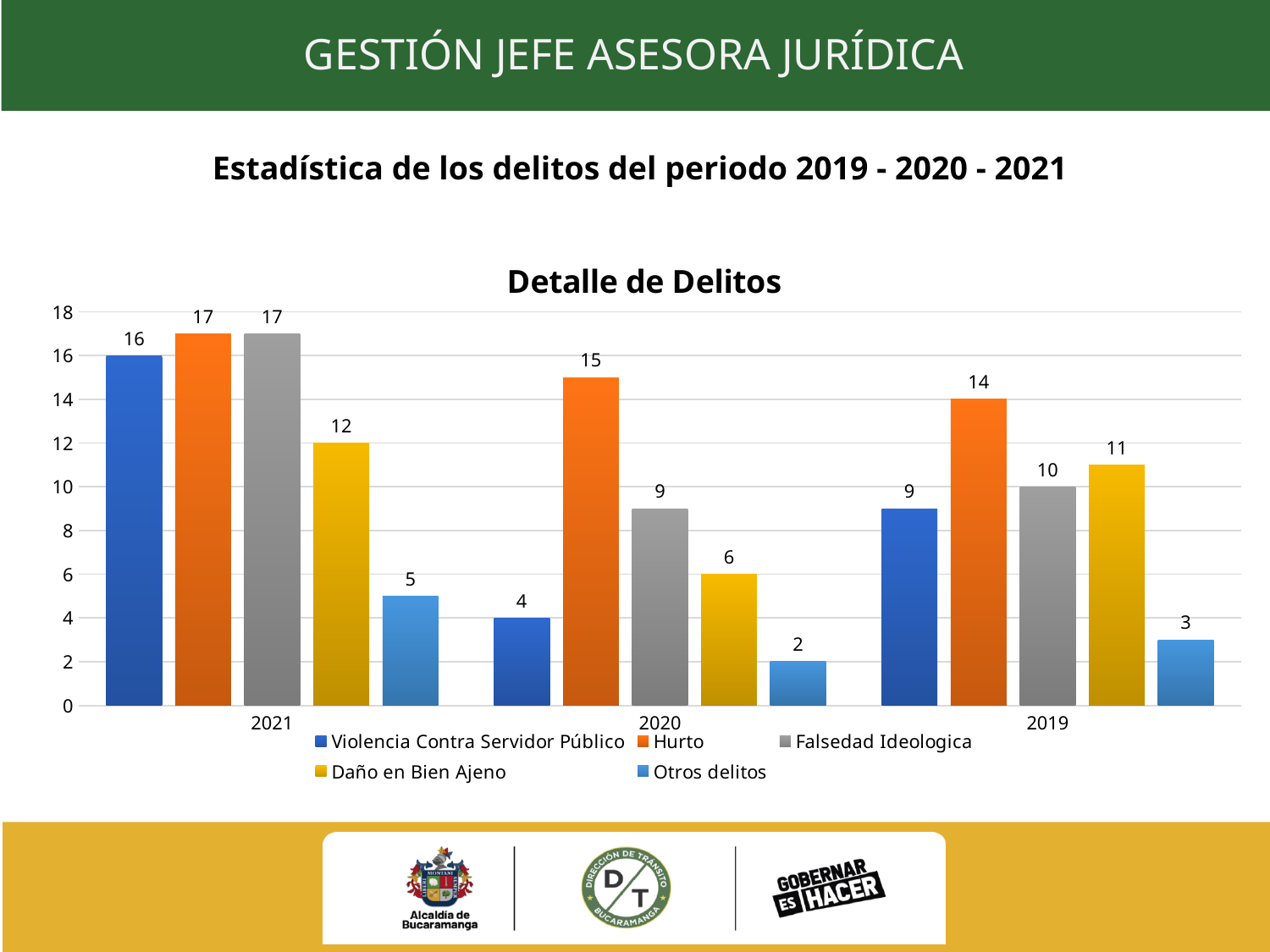
How many series does the legend list? 5 What is the title of the chart? Detalle de Delitos What kind of chart is this? Bar chart What is the value for Hurto in 2020? 15 What is the total of all five series in 2020? 36 Which year has the lowest value for Otros delitos? 2020 Which is larger: Falsedad Ideologica in 2020 or Daño en Bien Ajeno in 2020? Falsedad Ideologica in 2020 What is the value for Daño en Bien Ajeno in 2021? 12 How many years are shown on the x axis? 3 Which year has the highest value for Violencia Contra Servidor Público? 2021 What is the value for Otros delitos in 2019? 3 What is the difference between Hurto in 2021 and Hurto in 2019? 3